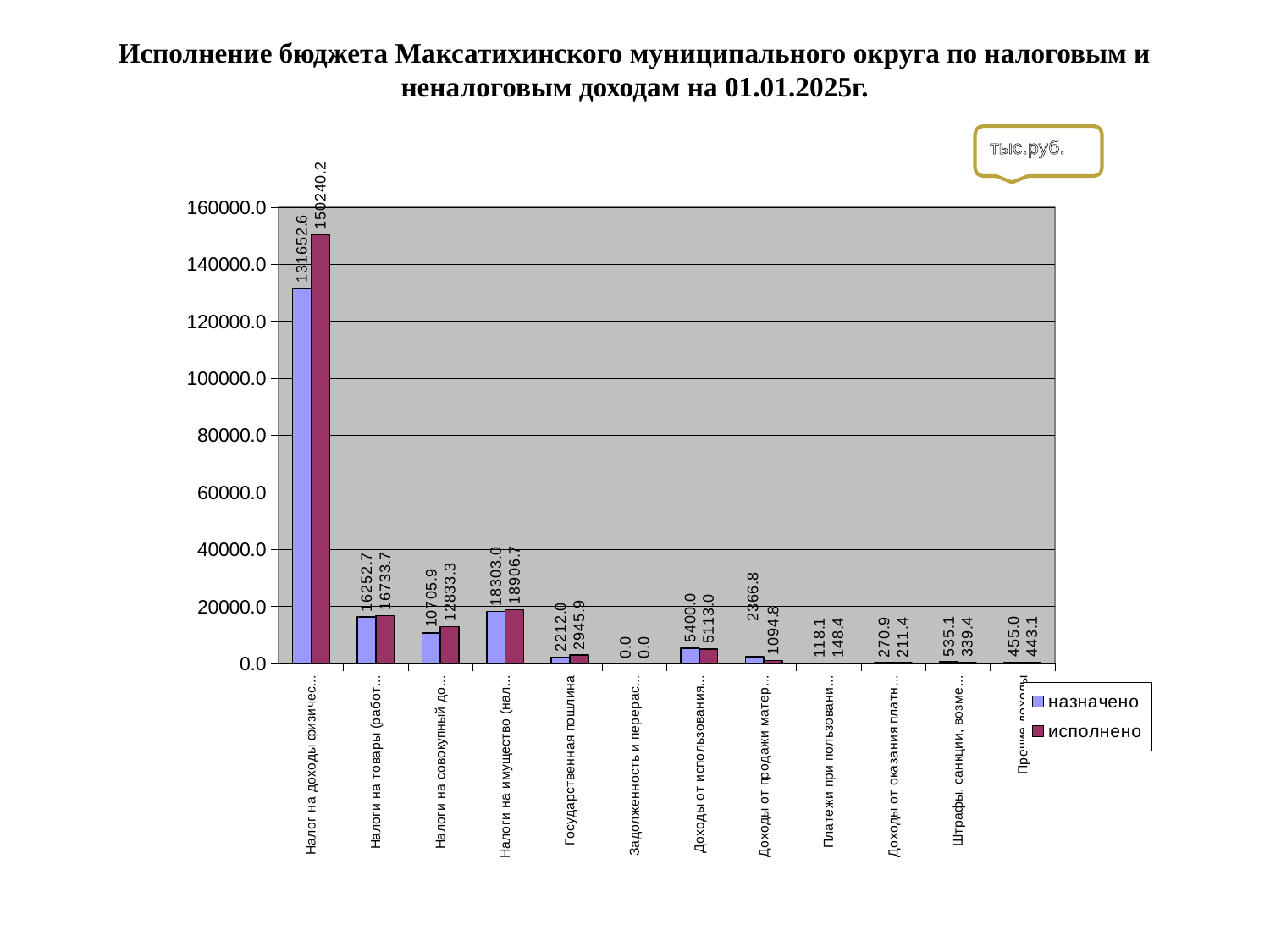
What is the 'назначено' value for 'Государственная пошлина'? 2212.0 Which category has the lowest 'назначено' value? Задолженность и перерас... What unit is indicated in the callout at the top right of the chart? тыс.руб. What is the 'назначено' value for 'Прочие доходы'? 455.0 What kind of chart is shown on the slide? bar chart Which category has the highest 'исполнено' value? Налог на доходы физичес... What is the difference between the 'исполнено' and 'назначено' values for the category whose label begins 'Налог на доходы физичес'? 18587.6 What is the 'исполнено' value for the category whose label begins 'Налог на доходы физичес'? 150240.2 For the category whose label begins 'Доходы от продажи матер', which is larger: 'назначено' or 'исполнено'? назначено What is the 'исполнено' value for 'Государственная пошлина'? 2945.9 How many categories are plotted along the x axis? 12 How many series does the legend list? 2